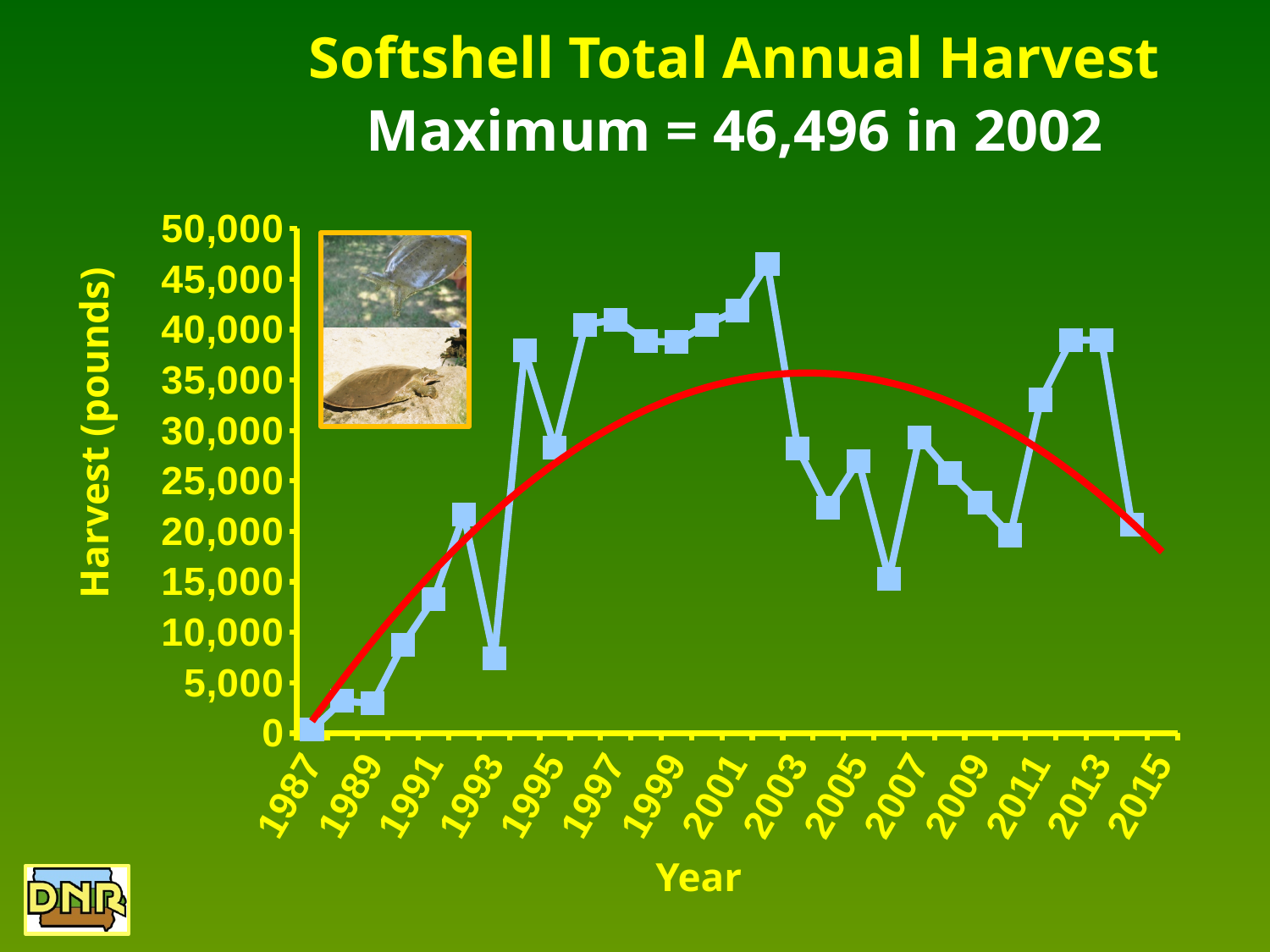
Is the harvest value for 1994 greater or less than 35,000? greater In which year was the softshell harvest lowest? 1987 Which year had a higher harvest, 2006 or 2012? 2012 Which year had a higher harvest, 1997 or 2003? 1997 Is the harvest value for 2006 greater or less than 20,000? less In which year was the softshell harvest highest? 2002 What was the maximum softshell annual harvest, as stated on the slide? 46,496 What kind of chart is shown on the slide? line chart Is the harvest value for 2003 greater or less than 35,000? less Does the harvest rise or fall from 1987 to 1992? rise What is the label on the vertical axis of the chart? Harvest (pounds)